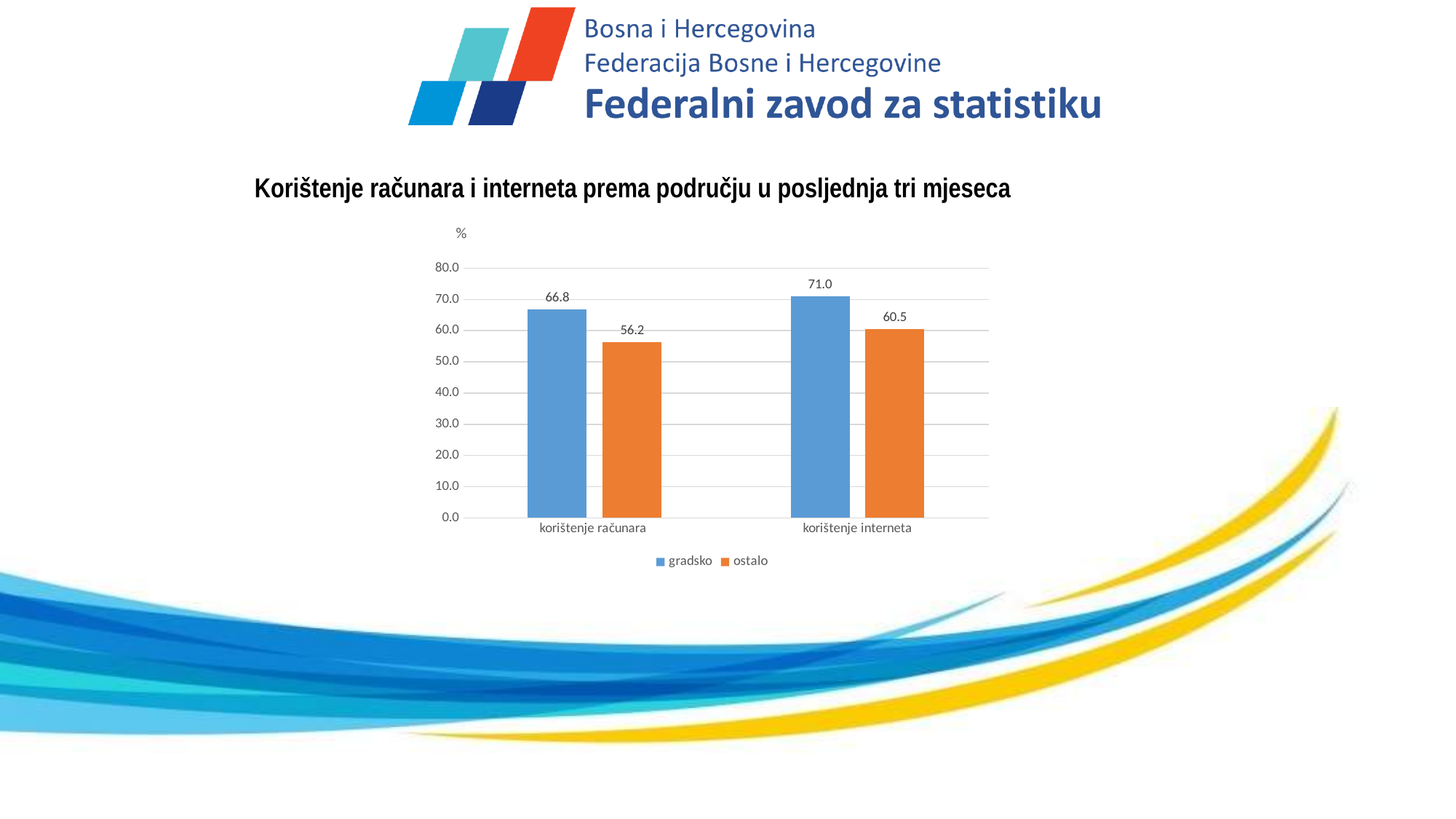
How many series does the legend list? 2 Which is larger for korištenje interneta: gradsko or ostalo? gradsko What kind of chart is shown on the slide? bar chart Which bar has the highest value on the chart? gradsko, korištenje interneta What is the value for gradsko in the korištenje računara category? 66.8 What is the difference between the gradsko and ostalo values for korištenje računara? 10.6 What is the value for ostalo in the korištenje interneta category? 60.5 Which bar has the lowest value on the chart? ostalo, korištenje računara What is the value for gradsko in the korištenje interneta category? 71.0 What is the value for ostalo in the korištenje računara category? 56.2 How many categories are shown on the x axis? 2 Is the value for ostalo in korištenje računara greater or less than 60.0? less